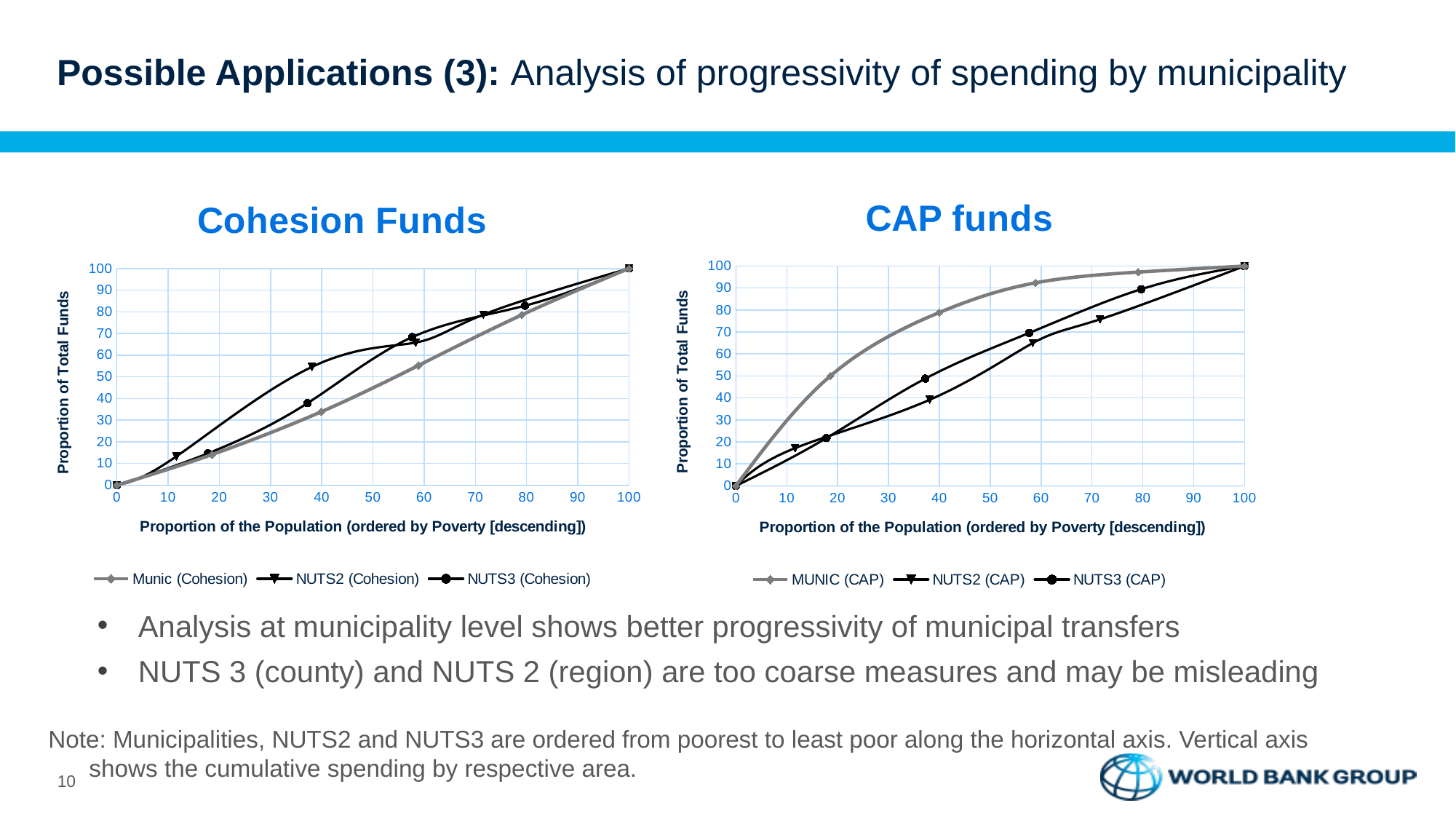
What kind of chart is the Cohesion Funds chart? line chart In the CAP funds chart, is the value of MUNIC (CAP) at 40 on the horizontal axis greater or less than 70? greater In the Cohesion Funds chart, what are the three series named in the legend? Munic (Cohesion), NUTS2 (Cohesion), NUTS3 (Cohesion) In the CAP funds chart, do the values of the MUNIC (CAP) series rise or fall as the proportion of the population increases? rise In the CAP funds chart, which series is highest at 60 on the horizontal axis? MUNIC (CAP) In the CAP funds chart, at 40 on the horizontal axis, which series is higher: MUNIC (CAP) or NUTS2 (CAP)? MUNIC (CAP) How many series does the legend of the CAP funds chart list? 3 In the Cohesion Funds chart, what value does the Munic (Cohesion) series reach at 100 on the horizontal axis? 100 In the Cohesion Funds chart, at 40 on the horizontal axis, which series is higher: NUTS2 (Cohesion) or Munic (Cohesion)? NUTS2 (Cohesion) In the CAP funds chart, what is the label of the vertical axis? Proportion of Total Funds In the Cohesion Funds chart, is the value of Munic (Cohesion) at 40 on the horizontal axis greater or less than 40? less In the CAP funds chart, is the value of NUTS2 (CAP) at 40 on the horizontal axis greater or less than 50? less